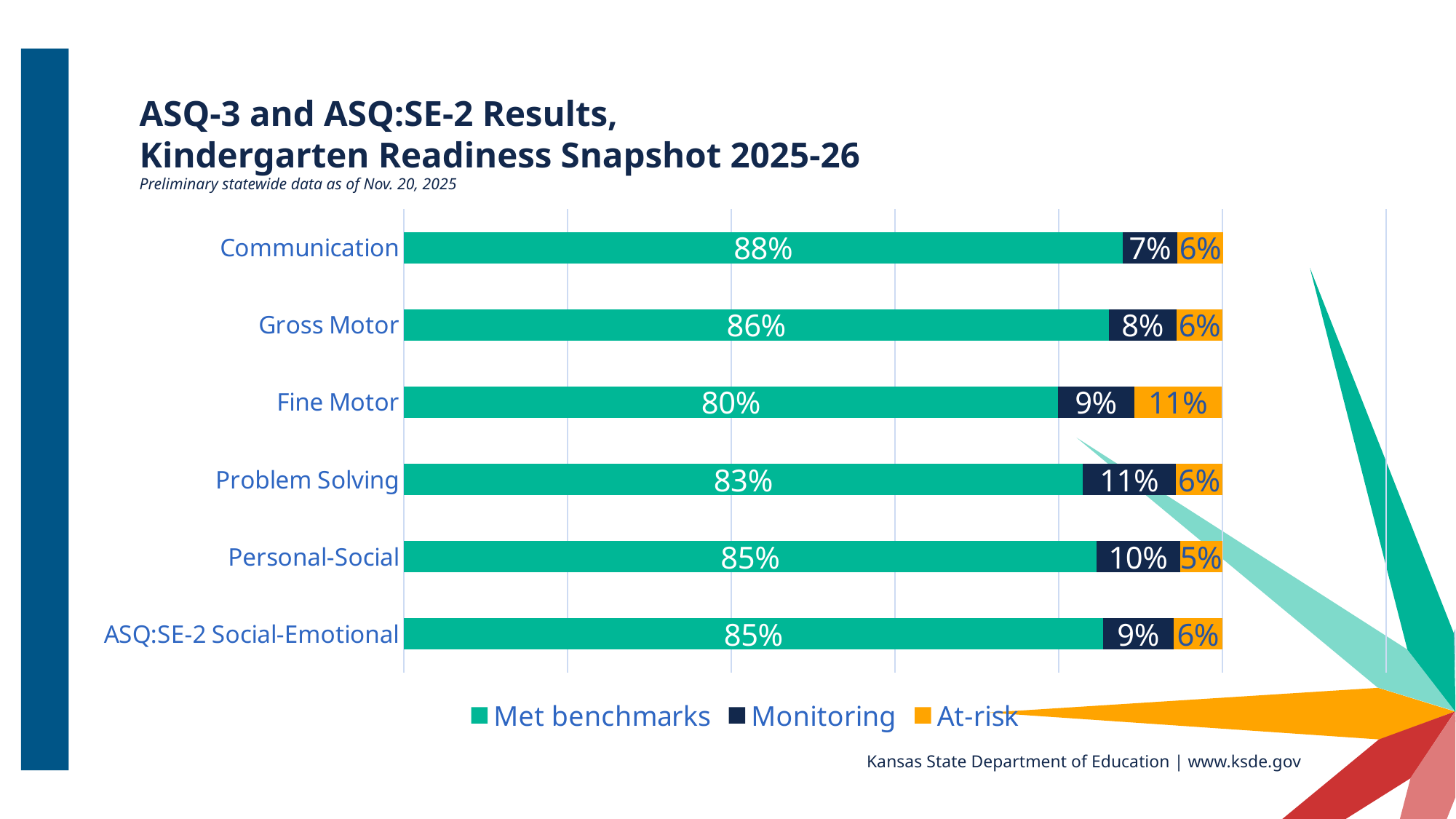
What is the At-risk percentage for Personal-Social? 5% Which category has the lowest Monitoring percentage? Communication Which has a larger Monitoring percentage, Gross Motor or Personal-Social? Personal-Social What percentage of children met benchmarks in Communication? 88% How many categories are shown in the chart? 6 What is the At-risk percentage for Fine Motor? 11% How many percentage points higher is the Met benchmarks value for Communication than for Fine Motor? 8 percentage points Which category has the highest Met benchmarks percentage? Communication How many series does the legend list? 3 What is the Monitoring percentage for Problem Solving? 11% Which category has the lowest Met benchmarks percentage? Fine Motor Which category has the highest At-risk percentage? Fine Motor